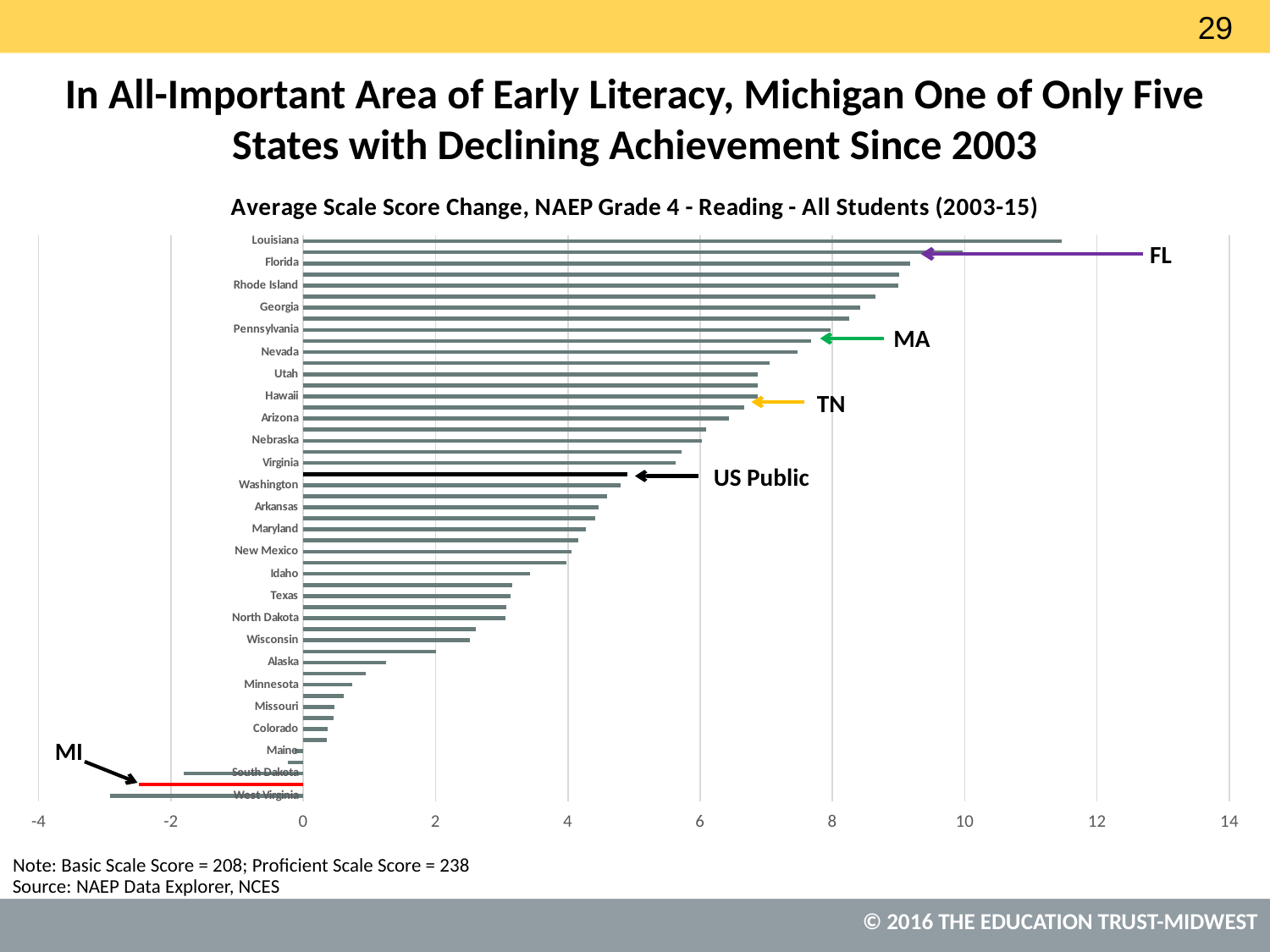
What kind of chart is shown on the slide? bar chart Is the value for Idaho greater or less than 4? less Which state's bar is highlighted in red on the chart? Michigan (MI) Is the value for Louisiana greater or less than 10? greater Which has a larger average scale score change, Louisiana or Florida? Louisiana Which state has the lowest average scale score change in the chart? West Virginia Is the value for Nevada greater or less than 6? greater Which state has the highest average scale score change in the chart? Louisiana What is the title of the chart? Average Scale Score Change, NAEP Grade 4 - Reading - All Students (2003-15)